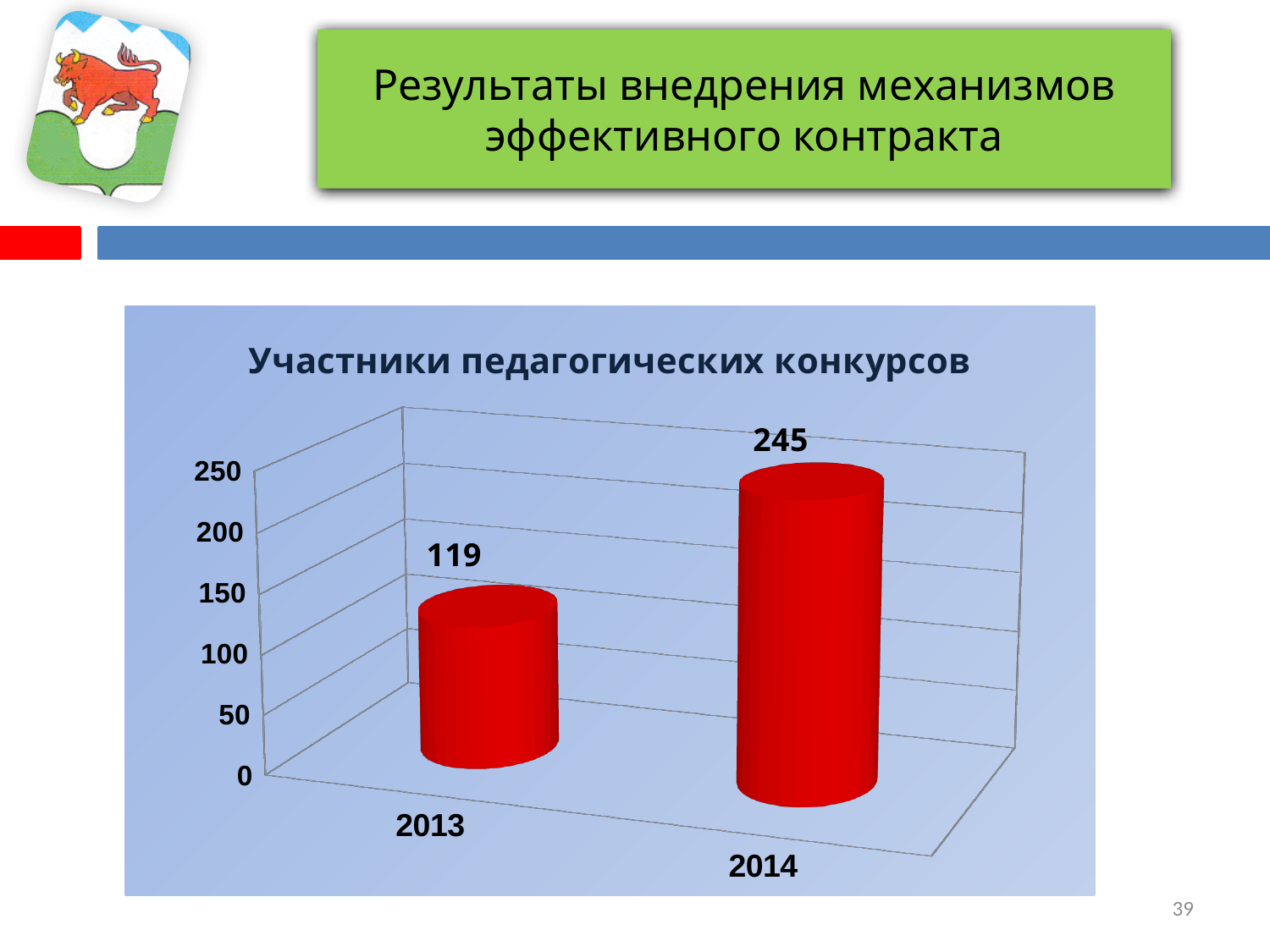
Which is larger, the value for 2013 or the value for 2014? 2014 How many categories are shown on the x axis of the chart? 2 Do the values rise or fall from 2013 to 2014? rise What is the difference between the values for 2014 and 2013? 126 Is the value for 2014 greater or less than 200? greater What is the value for 2014 in the chart? 245 What is the title of the chart? Участники педагогических конкурсов Is the value for 2013 greater or less than 150? less Which year has the highest value in the chart? 2014 What is the value for 2013 in the chart? 119 What kind of chart is shown on the slide? bar chart Which year has the lowest value in the chart? 2013